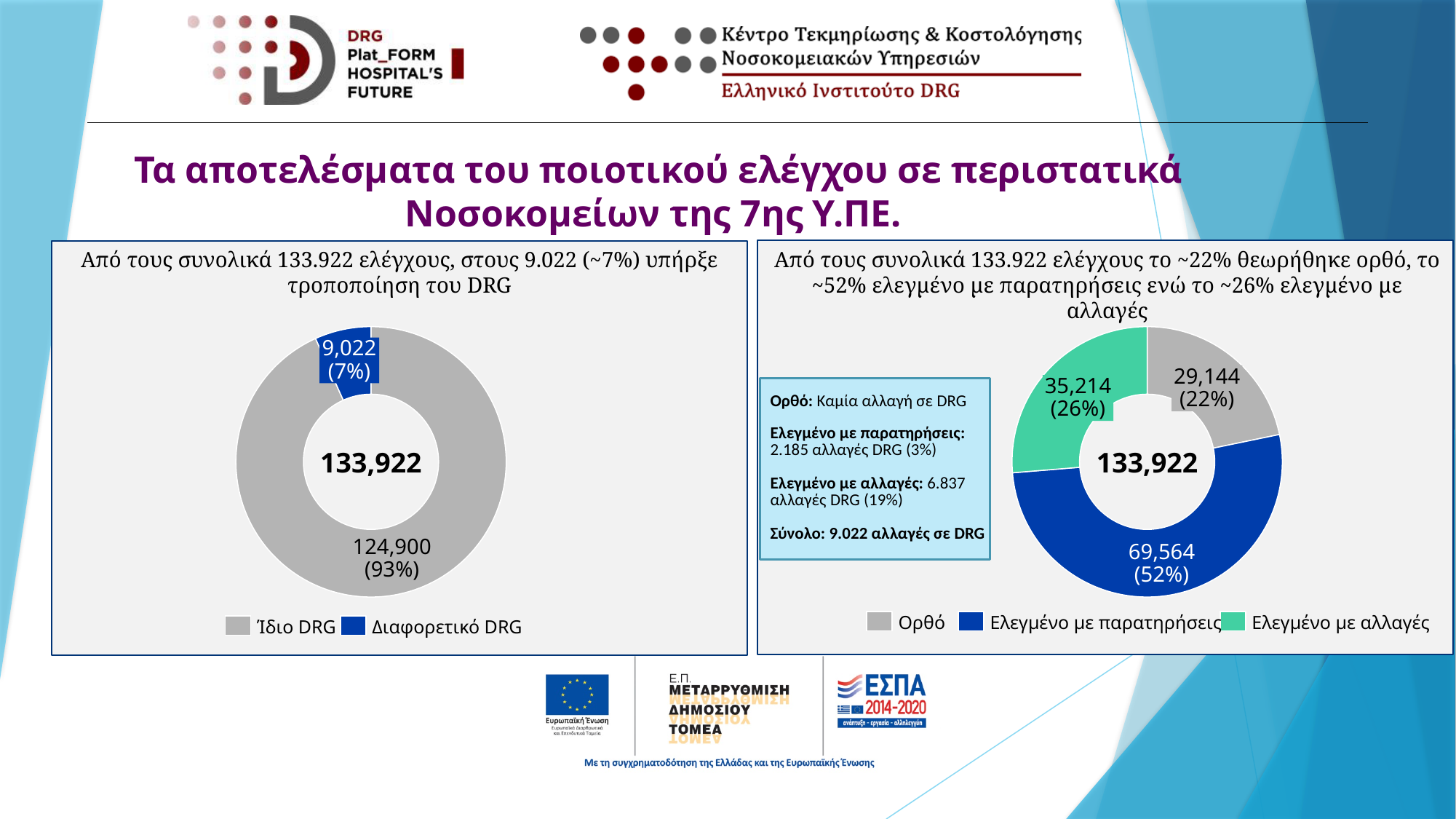
In the left chart, what is the difference between Ίδιο DRG and Διαφορετικό DRG? 115,878 In the right chart, which category has the largest value? Ελεγμένο με παρατηρήσεις In the left chart, what is the value for Ίδιο DRG? 124,900 In the left chart, what is the value for Διαφορετικό DRG? 9,022 How many categories does the legend of the right chart list? 3 In the left chart, what share of the total does Ίδιο DRG represent? 93% What kind of chart is the left chart? Donut (pie) chart In the right chart, what is the value for Ελεγμένο με παρατηρήσεις? 69,564 In the right chart, which is larger: Ελεγμένο με αλλαγές or Ορθό? Ελεγμένο με αλλαγές In the right chart, what share of the total does Ελεγμένο με αλλαγές represent? 26% In the right chart, what is the value for Ορθό? 29,144 In the right chart, which category has the smallest value? Ορθό